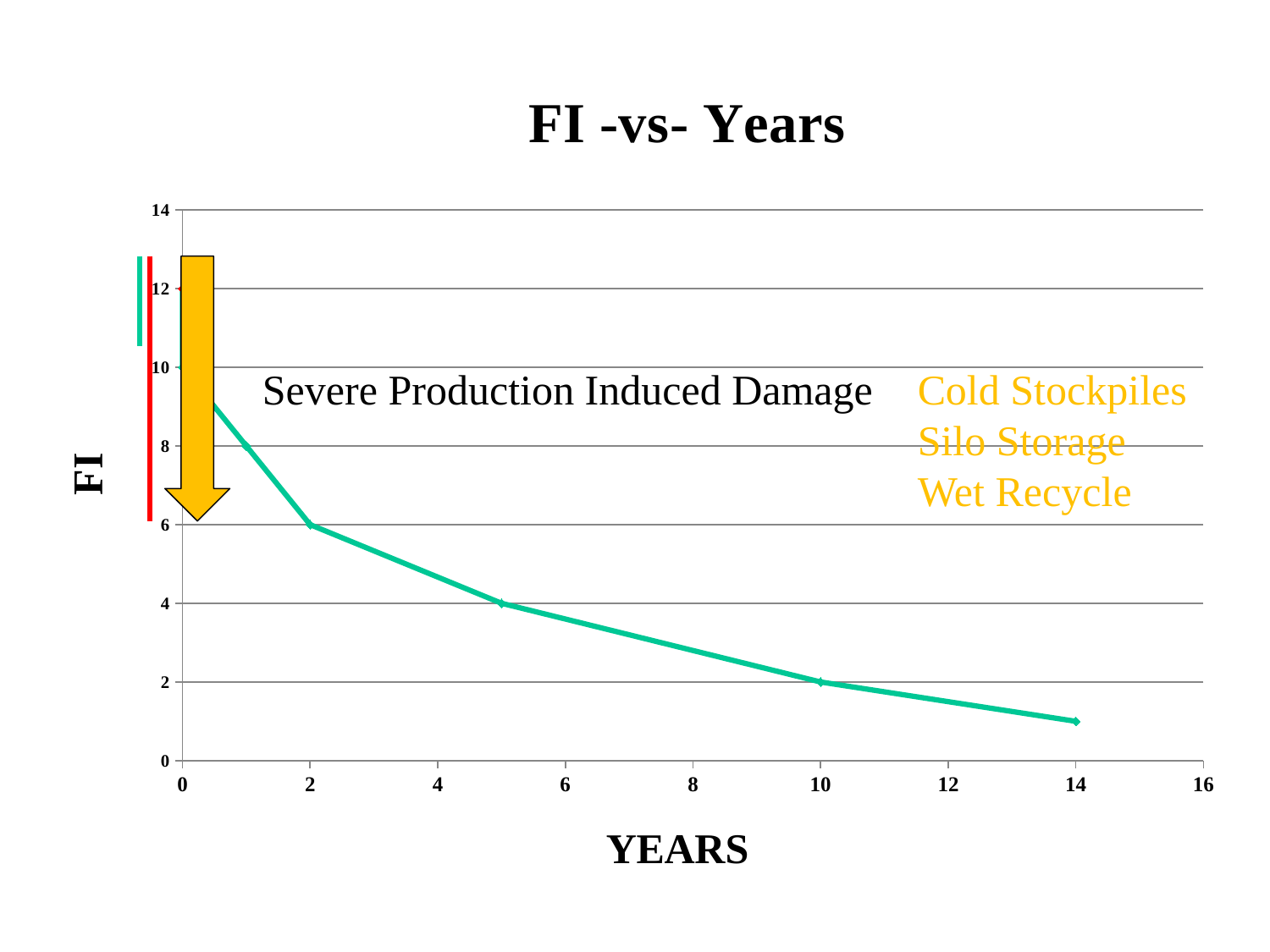
At which year is the FI value lowest? 14 What is the FI value at year 2? 6 Which has a higher FI value, year 2 or year 10? year 2 Is the FI value at year 8 greater or less than 2? greater Is the FI value at year 14 greater or less than 2? less What kind of chart is shown on the slide? line chart What is the FI value at year 10? 2 What is the title of the chart? FI -vs- Years Is the FI value at year 8 greater or less than 4? less What is the difference between the FI value at year 2 and the FI value at year 10? 4 Do the FI values rise or fall as the years increase? fall